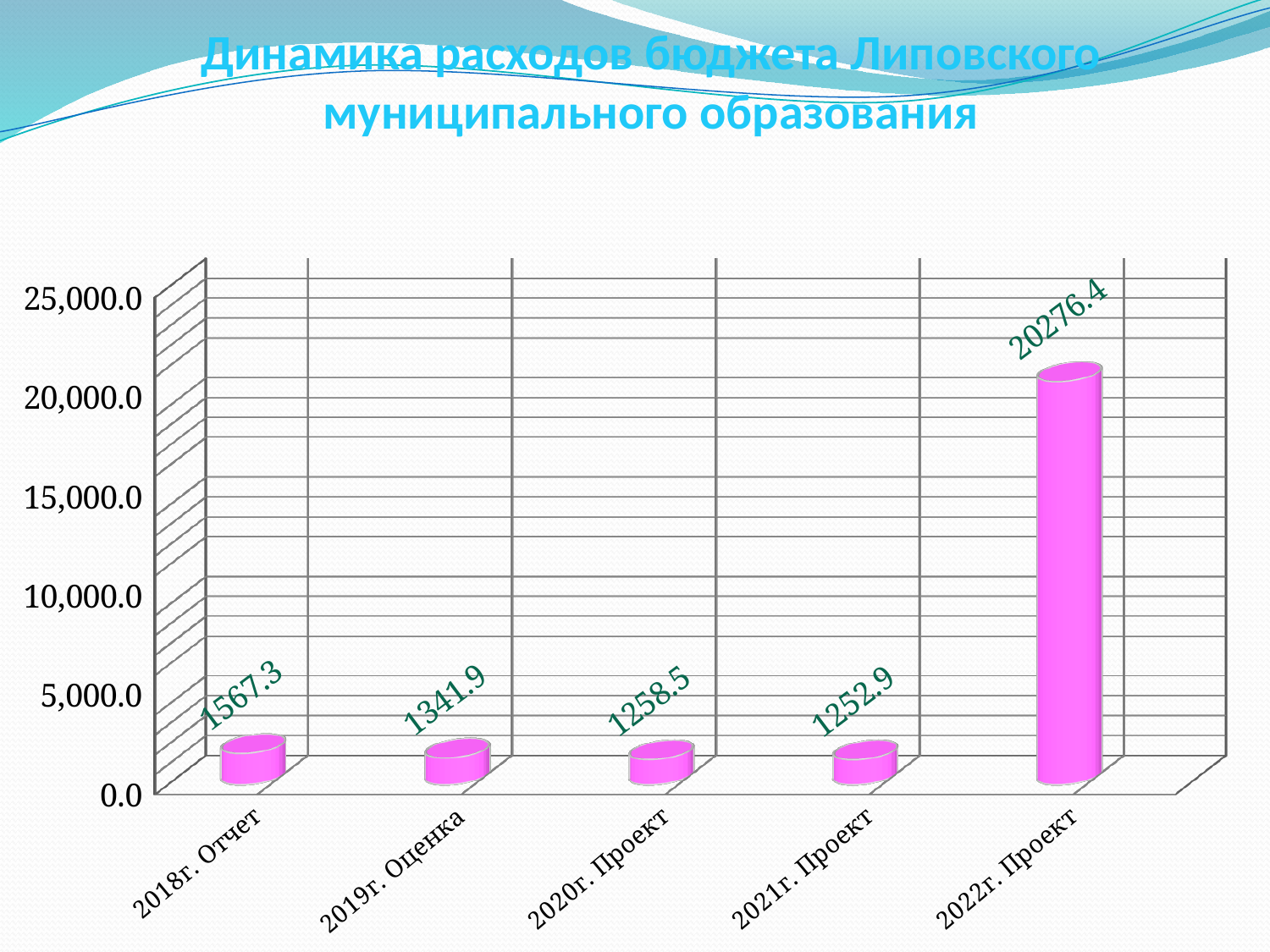
What is the value for 2022г. Проект? 20276.4 Which category has the highest value? 2022г. Проект What is the difference between the values for 2018г. Отчет and 2019г. Оценка? 225.4 What is the value for 2021г. Проект? 1252.9 Which is larger, the value for 2020г. Проект or the value for 2021г. Проект? 2020г. Проект Is the value for 2022г. Проект greater or less than 20,000.0? greater What is the value for 2018г. Отчет? 1567.3 What kind of chart is shown on the slide? Bar chart What is the difference between the values for 2022г. Проект and 2020г. Проект? 19017.9 How many categories are shown on the x axis? 5 Which category has the lowest value? 2021г. Проект What is the value for 2019г. Оценка? 1341.9